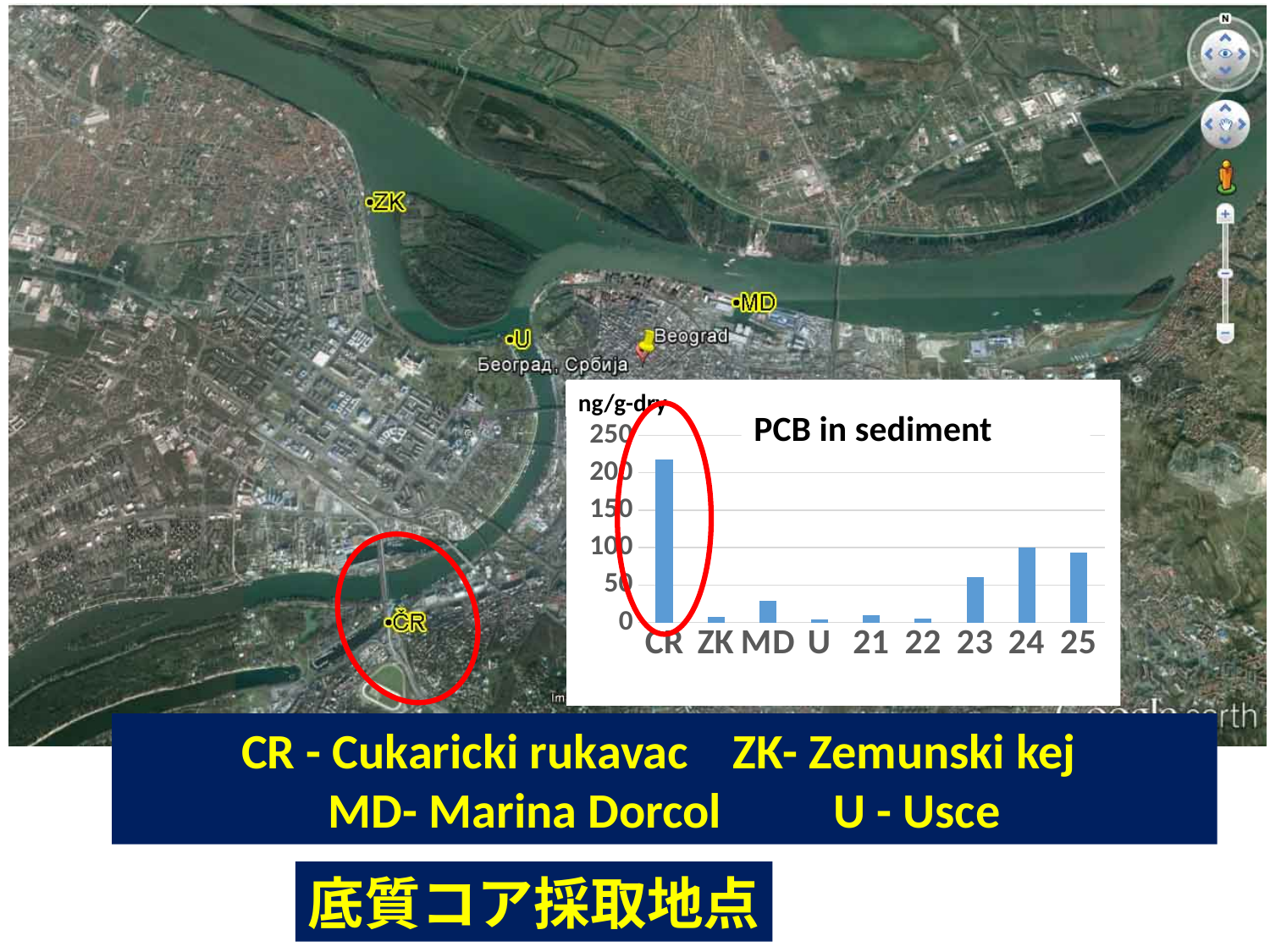
Is the value for 23 greater or less than 50? greater What is the title of the chart? PCB in sediment Which has a larger value, 24 or 23? 24 Which has a larger value, MD or U? MD What unit is shown on the chart's vertical axis? ng/g-dry What kind of chart is shown on the slide? bar chart How many categories are plotted on the x axis of the chart? 9 Which has a larger value, CR or 24? CR Is the value for CR greater or less than 200? greater Which category has the highest PCB in sediment value? CR Is the value for MD greater or less than 50? less